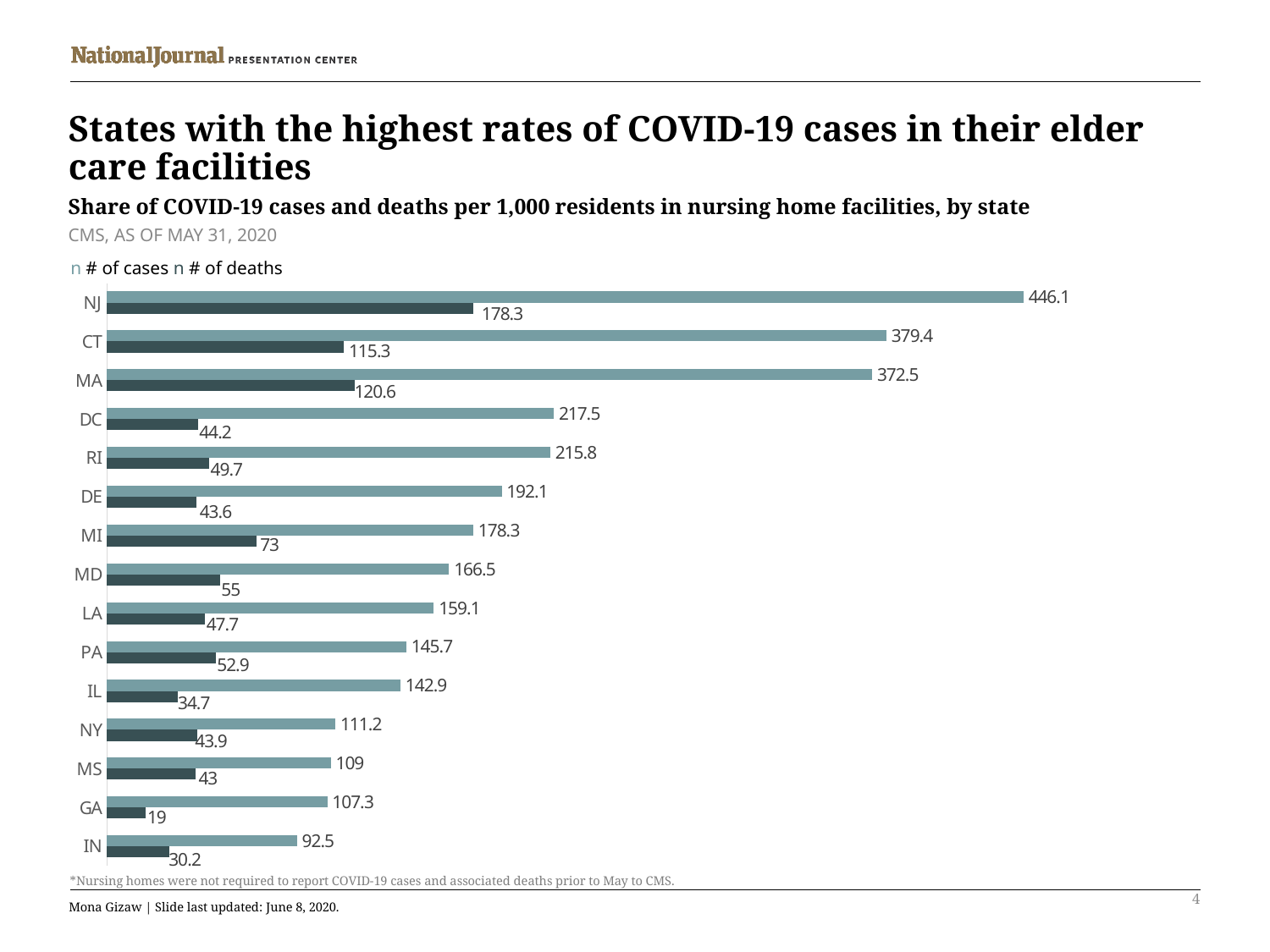
What is the difference between the number of cases for CT and MA? 6.9 What are the two series listed in the legend? # of cases and # of deaths What kind of chart is shown on the slide? Bar chart What is the number of cases per 1,000 residents for NJ? 446.1 Which state has the highest number of cases per 1,000 residents? NJ What is the difference between the number of cases and the number of deaths for NJ? 267.8 Which state has the lowest number of deaths per 1,000 residents? GA How many states are shown in the chart? 15 How many series does the legend list? 2 What is the number of cases per 1,000 residents for DC? 217.5 What is the number of deaths per 1,000 residents for MA? 120.6 Which state has more deaths per 1,000 residents, CT or MA? MA